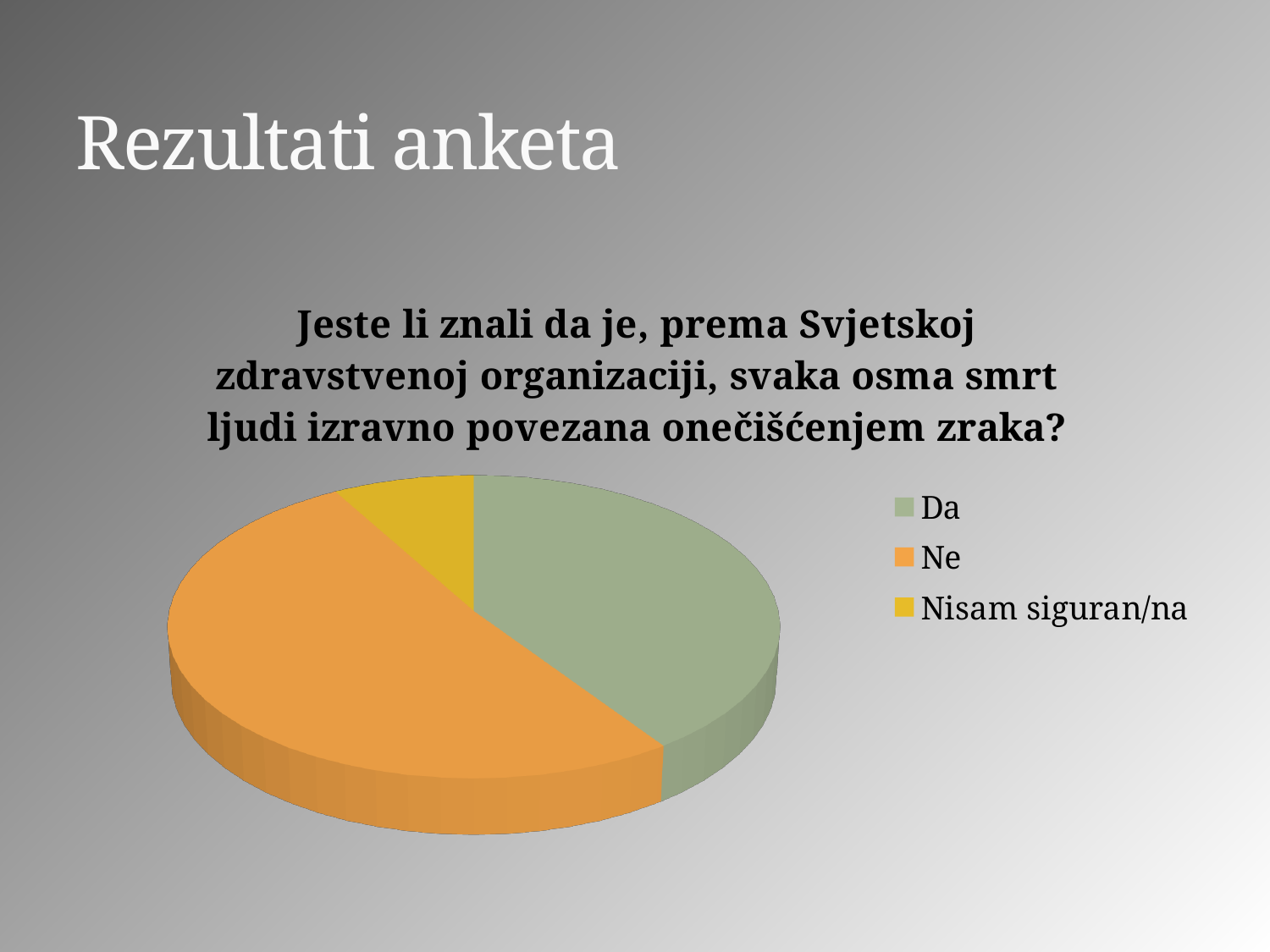
How many entries does the legend of the pie chart list? 3 Which slice is larger in the pie chart, "Da" or "Ne"? Ne How many slices does the pie chart have? 3 Which slice is larger in the pie chart, "Da" or "Nisam siguran/na"? Da Which answer category has the smallest slice of the pie chart? Nisam siguran/na What colour is the "Ne" slice in the pie chart? orange Which legend entry is shown in yellow in the pie chart? Nisam siguran/na Which slice is larger in the pie chart, "Ne" or "Nisam siguran/na"? Ne Which answer category has the largest slice of the pie chart? Ne What kind of chart is shown on the slide? pie chart